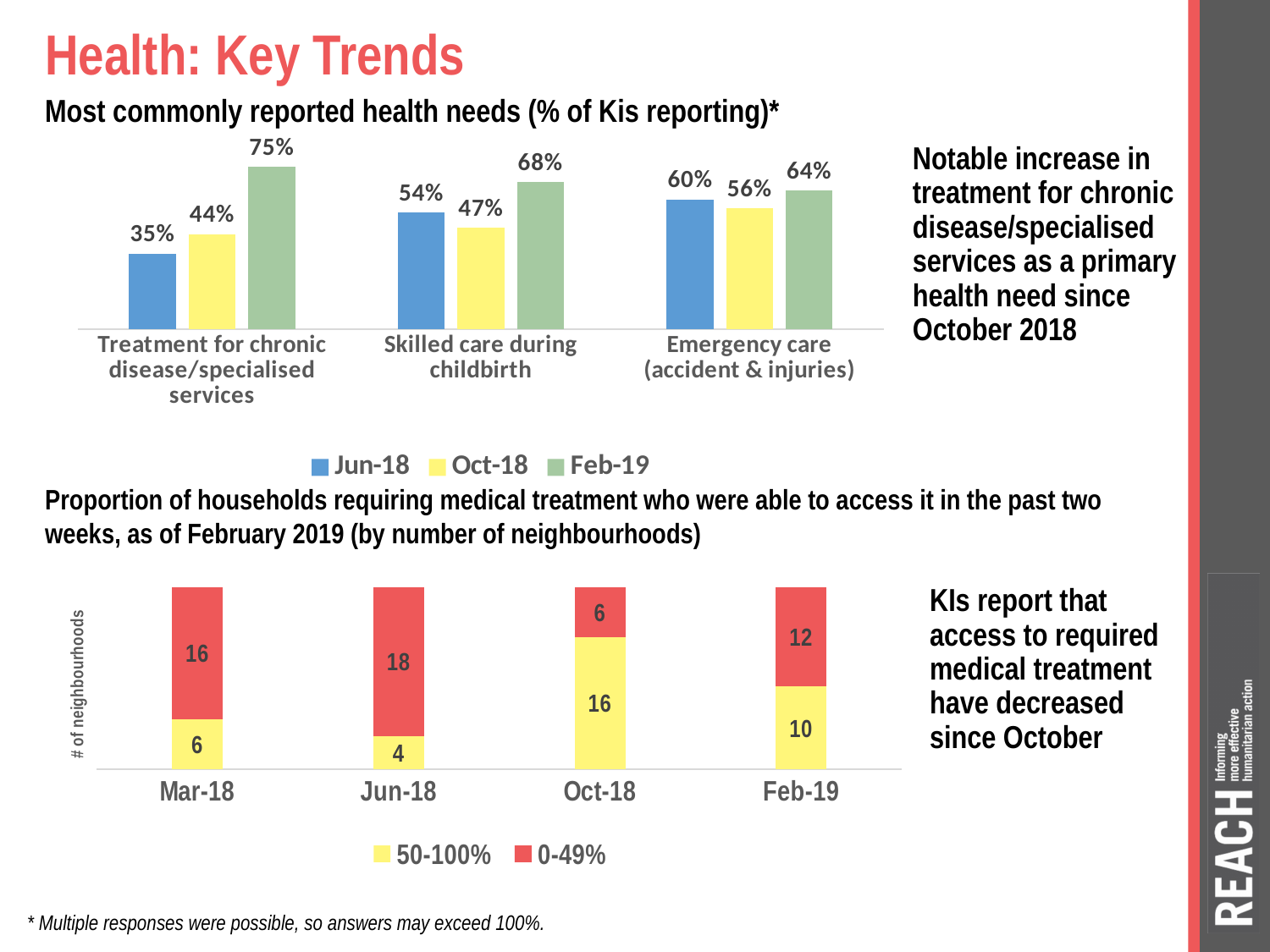
In the top chart (Most commonly reported health needs), what percentage of KIs reported emergency care (accident & injuries) in Jun-18? 60% In the top chart (Most commonly reported health needs), what percentage of KIs reported treatment for chronic disease/specialised services in Feb-19? 75% In the bottom chart (Proportion of households able to access medical treatment), what is the total number of neighbourhoods for Feb-19? 22 In the bottom chart (Proportion of households able to access medical treatment), how many neighbourhoods are in the 0-49% category for Jun-18? 18 In the top chart (Most commonly reported health needs), what is the difference between the Feb-19 and Jun-18 values for treatment for chronic disease/specialised services? 40% In the bottom chart (Proportion of households able to access medical treatment), how many neighbourhoods are in the 50-100% category for Oct-18? 16 In the top chart (Most commonly reported health needs), does the value for treatment for chronic disease/specialised services rise or fall from Jun-18 to Feb-19? rise In the top chart (Most commonly reported health needs), how many series does the legend list? 3 In the top chart (Most commonly reported health needs), what percentage of KIs reported skilled care during childbirth in Oct-18? 47% What kind of chart is the bottom chart (Proportion of households able to access medical treatment)? Stacked bar chart In the top chart (Most commonly reported health needs), which health need had the highest percentage in Feb-19? Treatment for chronic disease/specialised services In the bottom chart (Proportion of households able to access medical treatment), how many time periods are shown on the x axis? 4